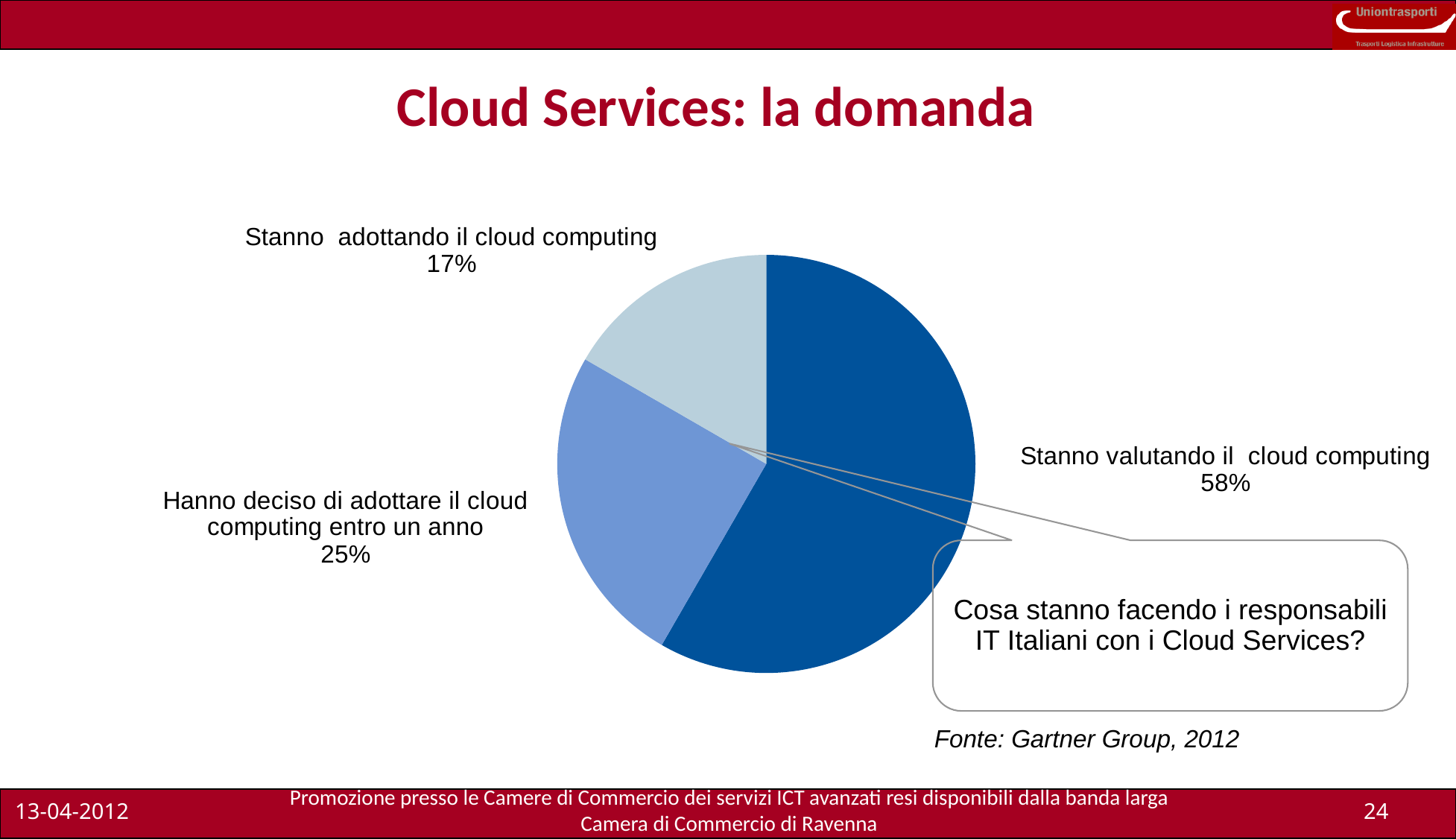
What type of chart is shown on the slide? pie chart How many slices does the pie chart have? 3 Which category has the largest slice of the pie? Stanno valutando il cloud computing What source is cited for the pie chart data? Gartner Group, 2012 What is the difference in percentage points between 'Hanno deciso di adottare il cloud computing entro un anno' and 'Stanno adottando il cloud computing'? 8 What share of the pie is labelled 'Stanno adottando il cloud computing'? 17% Which is larger: the share for 'Hanno deciso di adottare il cloud computing entro un anno' or the share for 'Stanno adottando il cloud computing'? Hanno deciso di adottare il cloud computing entro un anno What share of the pie is labelled 'Stanno valutando il cloud computing'? 58% Which category has the smallest slice of the pie? Stanno adottando il cloud computing What share of the pie is labelled 'Hanno deciso di adottare il cloud computing entro un anno'? 25% What is the title of the slide containing the pie chart? Cloud Services: la domanda What is the difference in percentage points between 'Stanno valutando il cloud computing' and 'Hanno deciso di adottare il cloud computing entro un anno'? 33